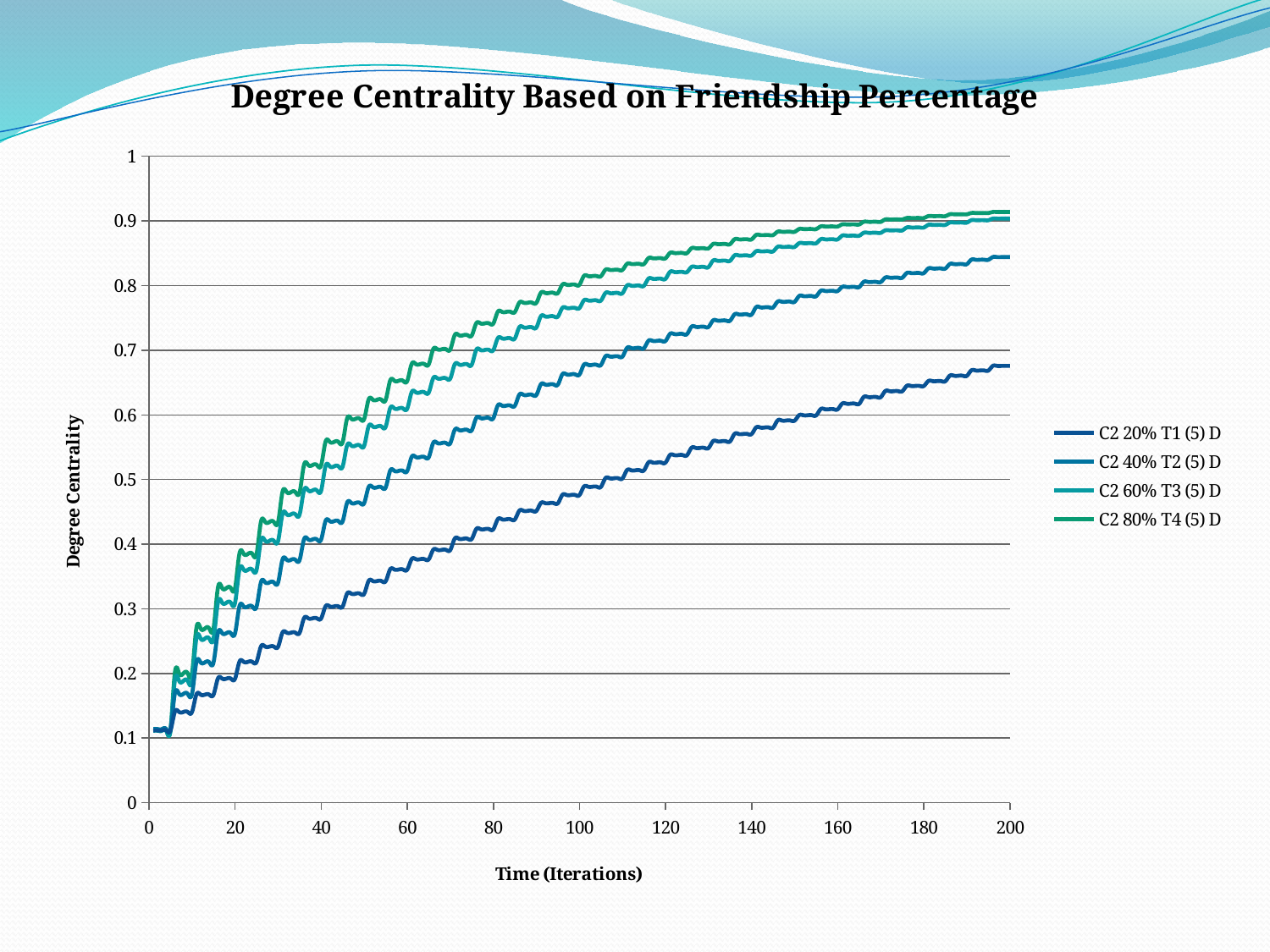
Is the value for C2 80% T4 (5) D at 60 iterations greater or less than 0.6? greater What is the title of the chart? Degree Centrality Based on Friendship Percentage Is the value for C2 40% T2 (5) D at 200 iterations greater or less than 0.8? greater At 100 iterations, which series has the higher value, C2 20% T1 (5) D or C2 80% T4 (5) D? C2 80% T4 (5) D At 200 iterations, which series has the higher value, C2 40% T2 (5) D or C2 20% T1 (5) D? C2 40% T2 (5) D How many series does the legend list? 4 Which series has the lowest degree centrality at 200 iterations? C2 20% T1 (5) D Do the values of the C2 20% T1 (5) D series rise or fall as time increases? rise What kind of chart is shown on the slide? line chart Is the value for C2 20% T1 (5) D at 80 iterations greater or less than 0.5? less What is the label of the x axis? Time (Iterations)